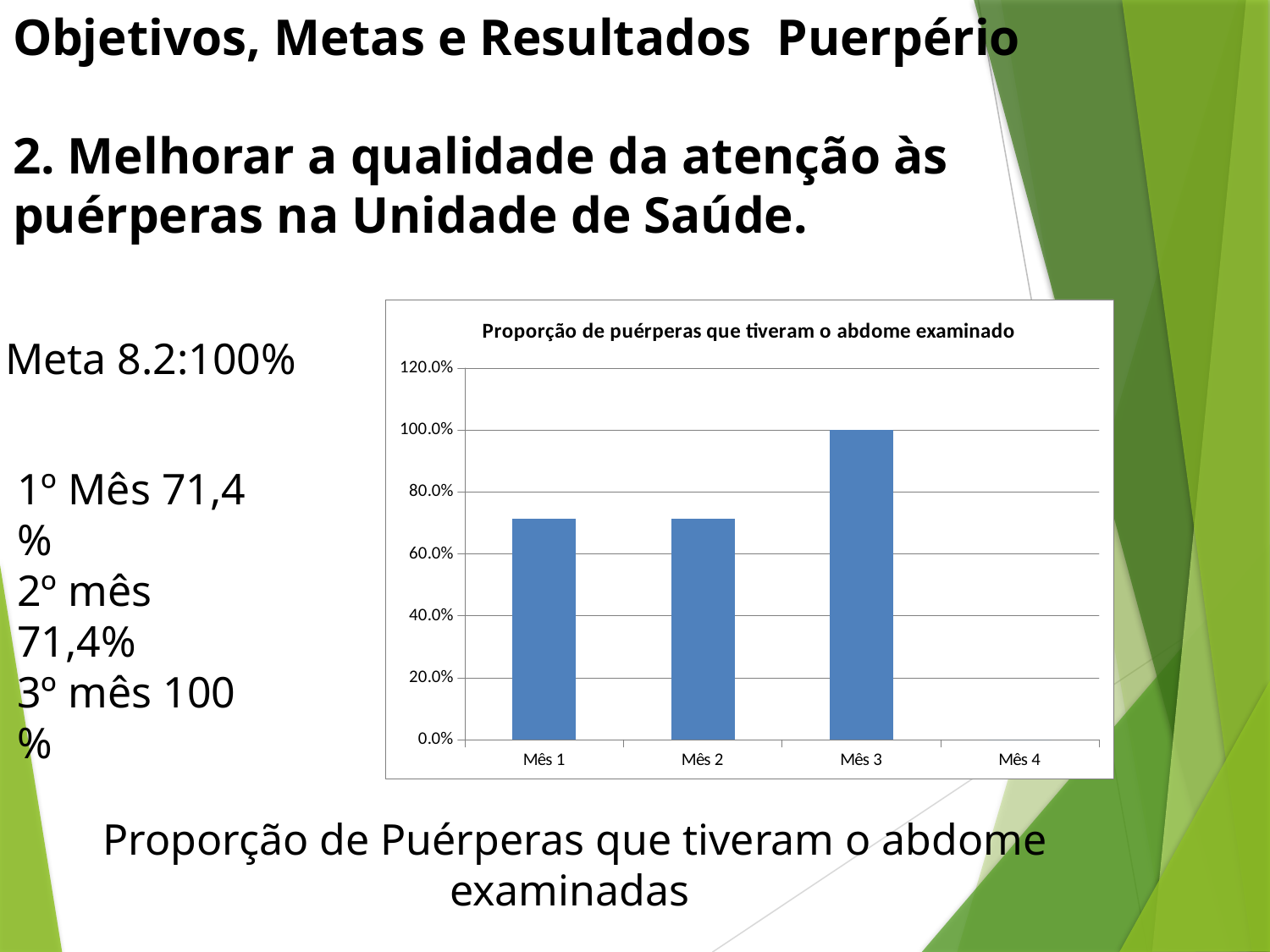
Do the values rise or fall from Mês 1 to Mês 3? rise What is the value for Mês 2? 71,4% What is the value for Mês 1? 71,4% Which month has the highest value in the chart? Mês 3 Which is larger, the value for Mês 3 or the value for Mês 1? Mês 3 What is the value for Mês 3? 100.0% What kind of chart is shown on the slide? bar chart How many categories are shown on the x axis of the chart? 4 Is the value for Mês 1 greater or less than 60.0%? greater What is the difference between the value for Mês 3 and the value for Mês 1? 28,6% What is the title of the chart? Proporção de puérperas que tiveram o abdome examinado Is the value for Mês 2 greater or less than 80.0%? less